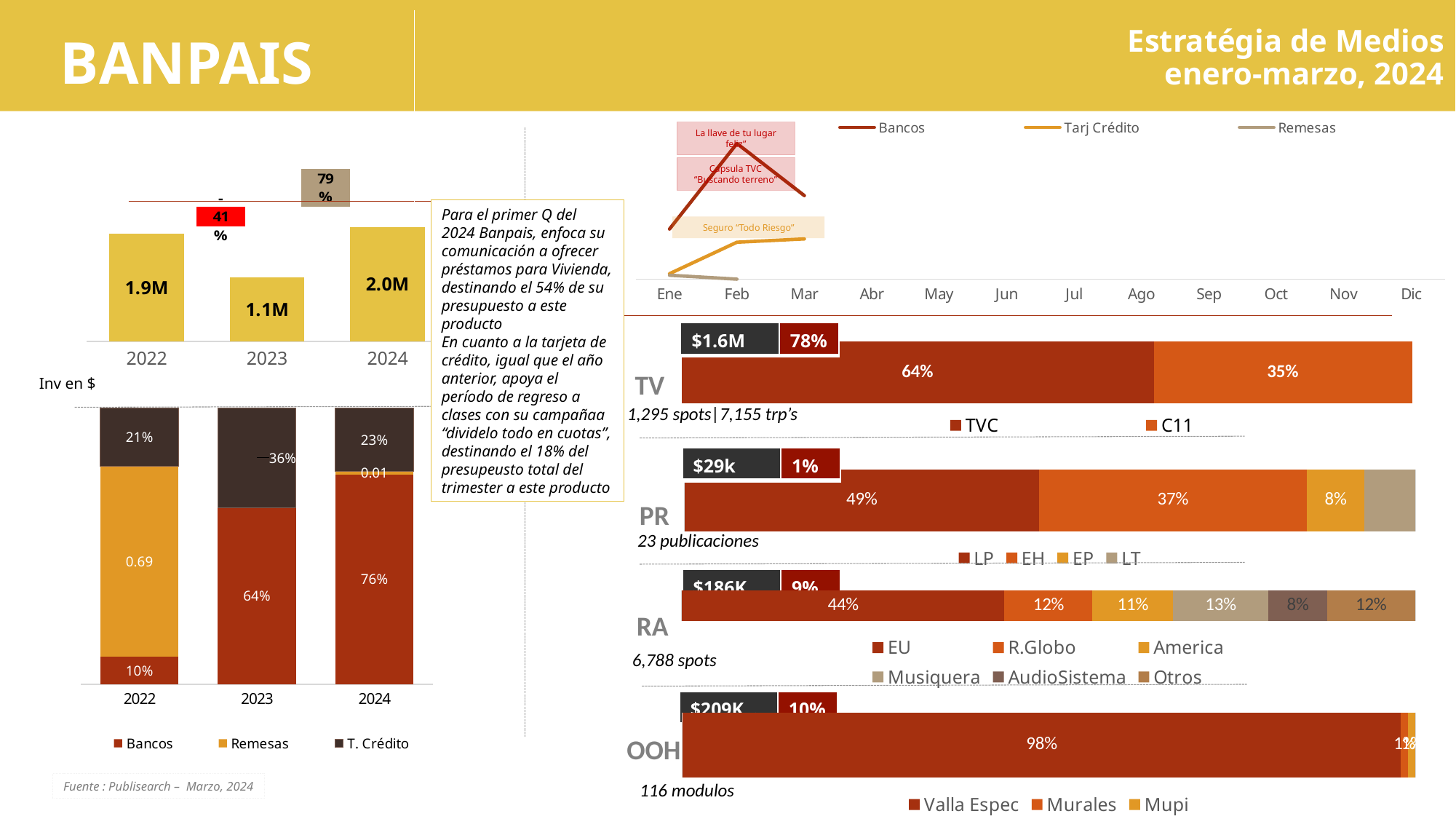
In the stacked bar chart at the bottom left, how many series does the legend list? 3 In the TV bar on the right, what is the share for TVC? 64% In the stacked bar chart at the bottom left, what is the Bancos share for 2024? 76% In the stacked bar chart at the bottom left, what is the T. Crédito share for 2023? 36% In the 'Inv en $' bar chart on the left, what is the value for 2024? 2.0M In the 'Inv en $' bar chart on the left, what kind of chart is it? bar chart In the OOH bar on the right, what is the share for Valla Espec? 98% In the stacked bar chart at the bottom left, is the Bancos share larger in 2023 or 2024? 2024 In the line chart at the top right, how many series does the legend list? 3 In the 'Inv en $' bar chart on the left, which year has the lowest investment? 2023 In the PR bar on the right, what is the difference between the LP share and the EH share? 12% In the RA bar on the right, which station has the highest share? EU